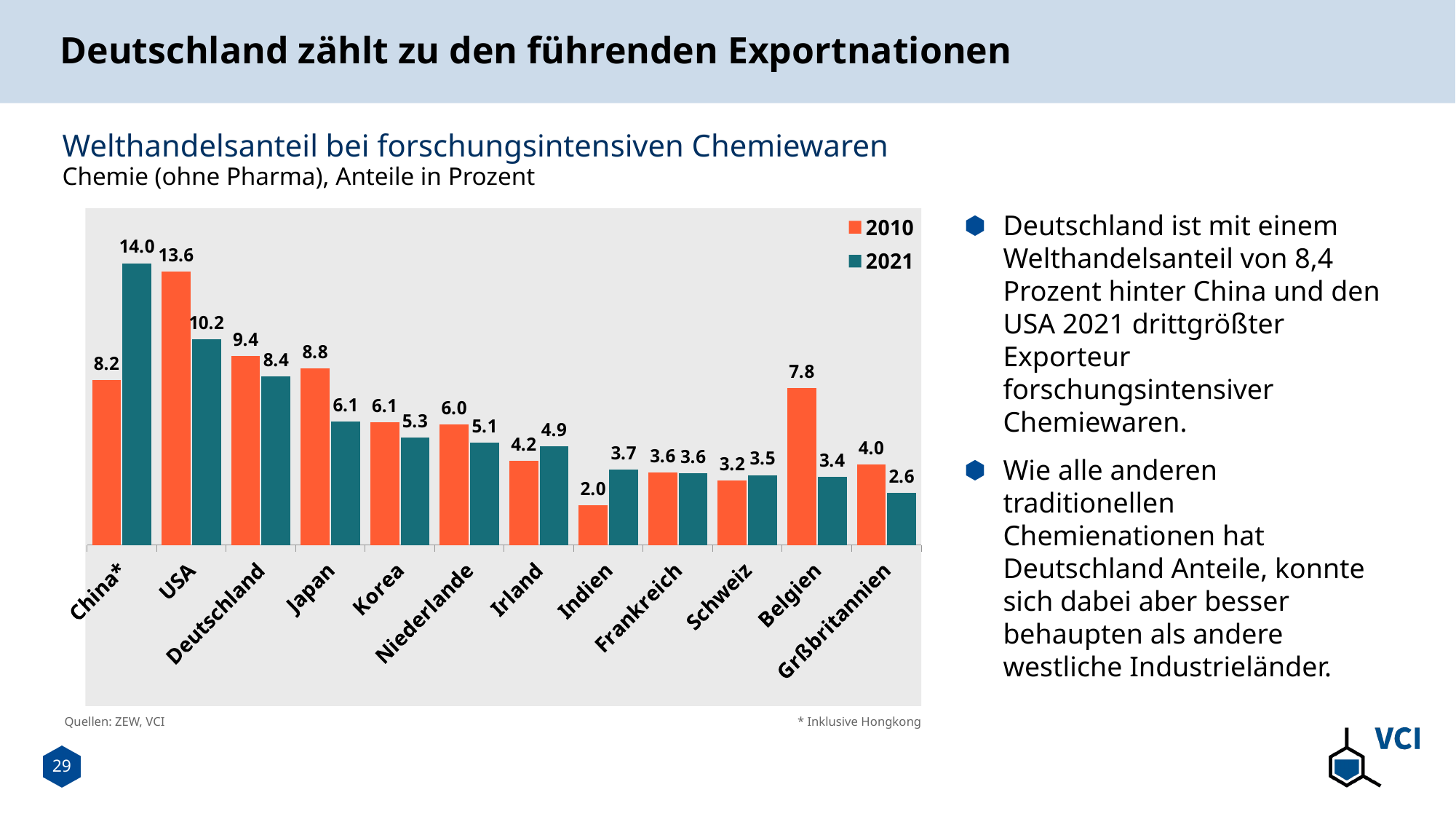
What is the 2021 value for Belgien? 3.4 What is the 2010 value for Deutschland? 9.4 What is the difference between the 2010 and 2021 values for Belgien? 4.4 Which is larger for Japan: the 2010 value or the 2021 value? 2010 How many countries are shown on the x axis? 12 Which country has the lowest 2010 value? Indien Which series is shown in orange according to the legend? 2010 How many series does the legend list? 2 What kind of chart is shown? Bar chart What is the 2021 value for China*? 14.0 Which country has the highest 2010 value? USA What is the difference between the 2021 values for China* and USA? 3.8